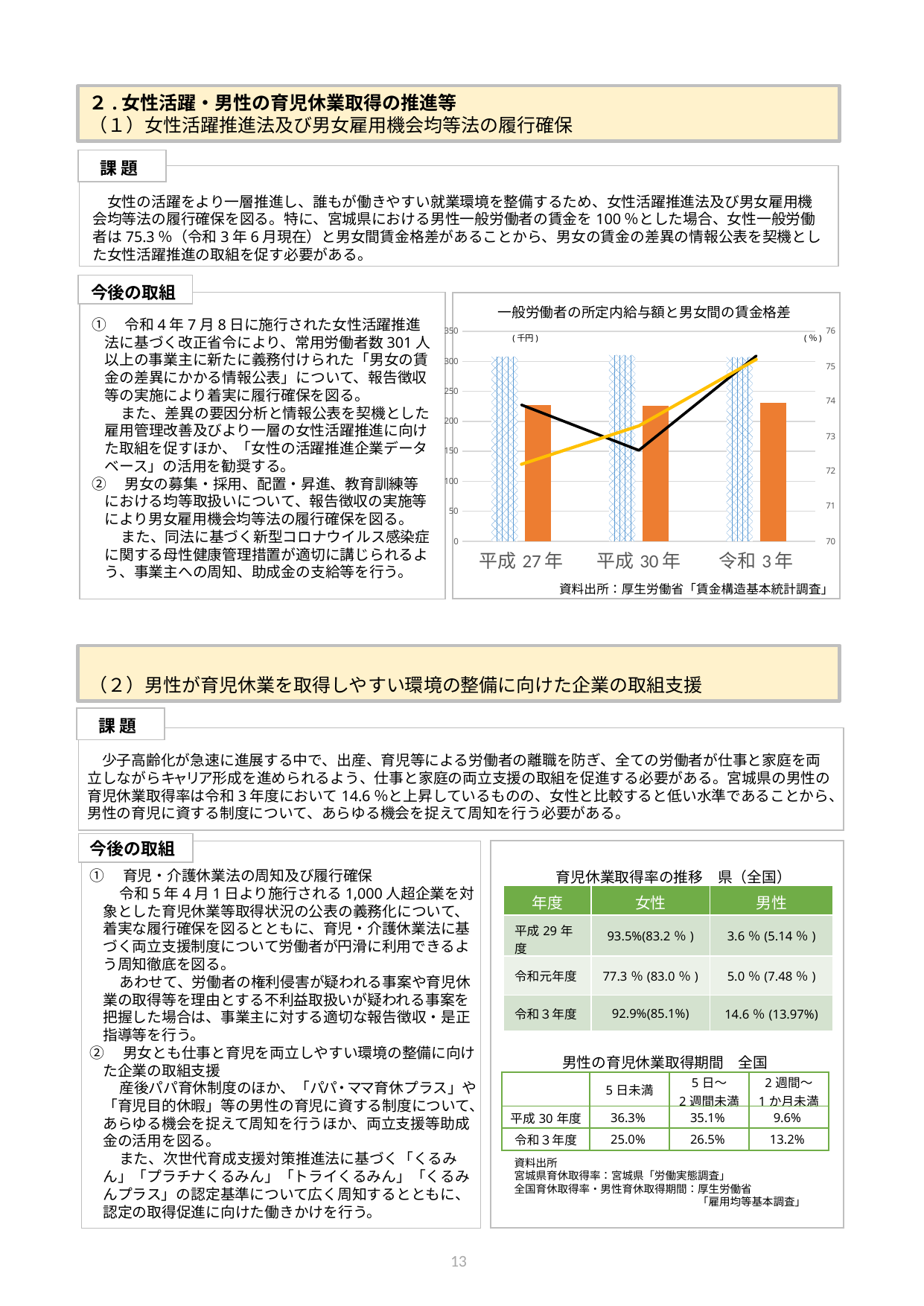
In the chart, which bar is taller for 令和3年, the blue patterned bar or the orange bar? The blue patterned bar What are the three categories on the x axis of the chart? 平成27年, 平成30年, 令和3年 In the chart, which line is higher at 平成27年, the black line or the yellow line? The black line In the chart, does the yellow line rise or fall from 平成27年 to 令和3年? It rises In the chart, is the value of the orange bar for 令和3年 greater or less than 200 on the left axis? greater In the chart, is the value of the yellow line at 平成27年 greater or less than 73 on the right axis? less What is the title of the chart on the slide? 一般労働者の所定内給与額と男女間の賃金格差 In the chart, is the value of the orange bar for 平成27年 greater or less than 250 on the left axis? less In the chart, does the black line rise or fall from 平成27年 to 平成30年? It falls What kind of chart is shown under the title 一般労働者の所定内給与額と男女間の賃金格差? A combined bar and line chart How many year categories are shown on the x axis of the chart? 3